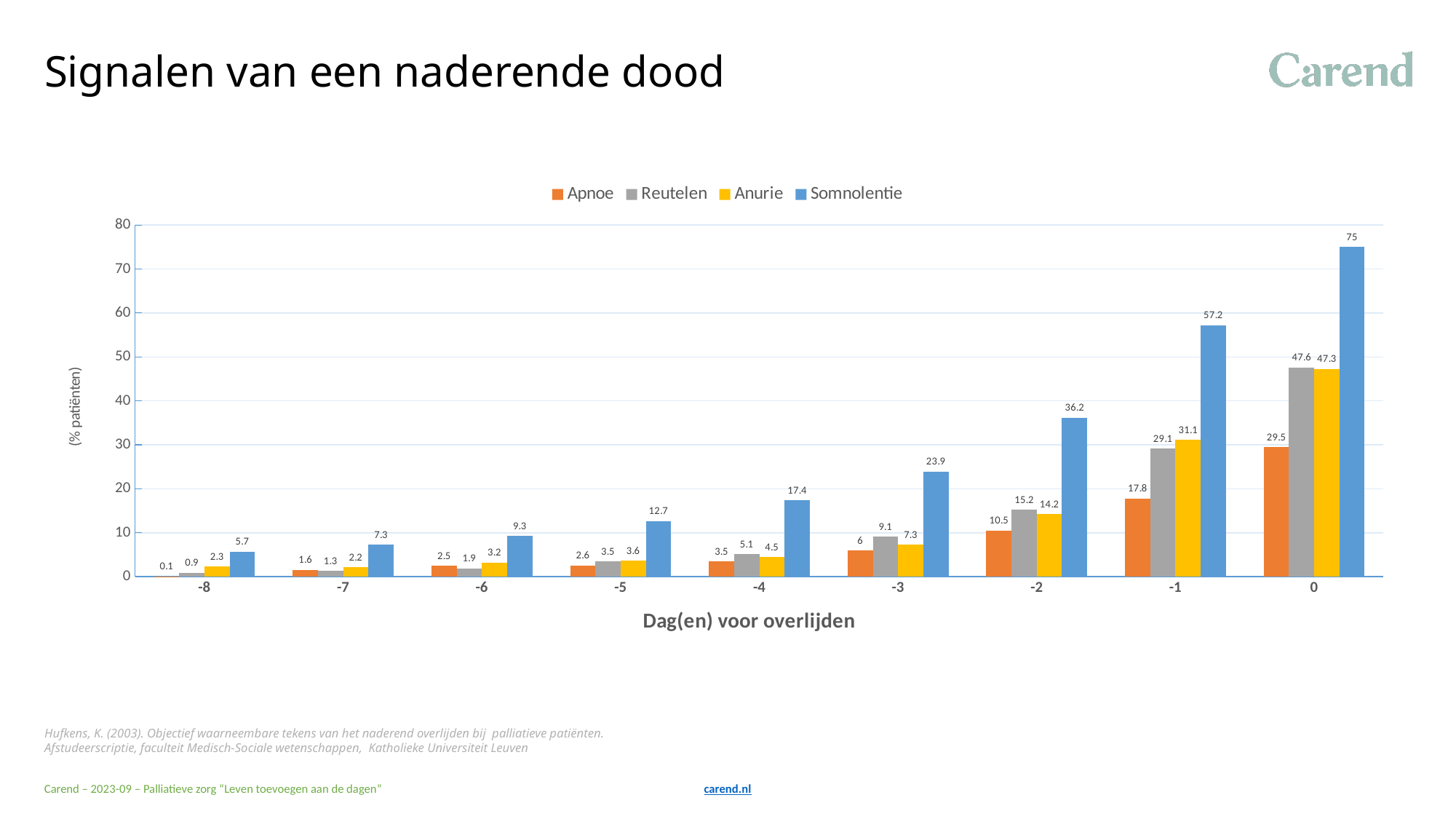
Which day has the lowest value for Apnoe? -8 What is the value for Reutelen at day -3? 9.1 At day -1, which is larger: Reutelen or Anurie? Anurie Do the Somnolentie values rise or fall from day -8 to day 0? Rise What is the value for Anurie at day -2? 14.2 Which day has the highest value for Somnolentie? 0 What is the value for Apnoe at day -1? 17.8 How many days (categories) are shown on the x axis? 9 How many series does the legend list? 4 What is the difference between Somnolentie and Apnoe at day 0? 45.5 What is the value for Somnolentie at day 0? 75 What kind of chart is shown on the slide? Bar chart